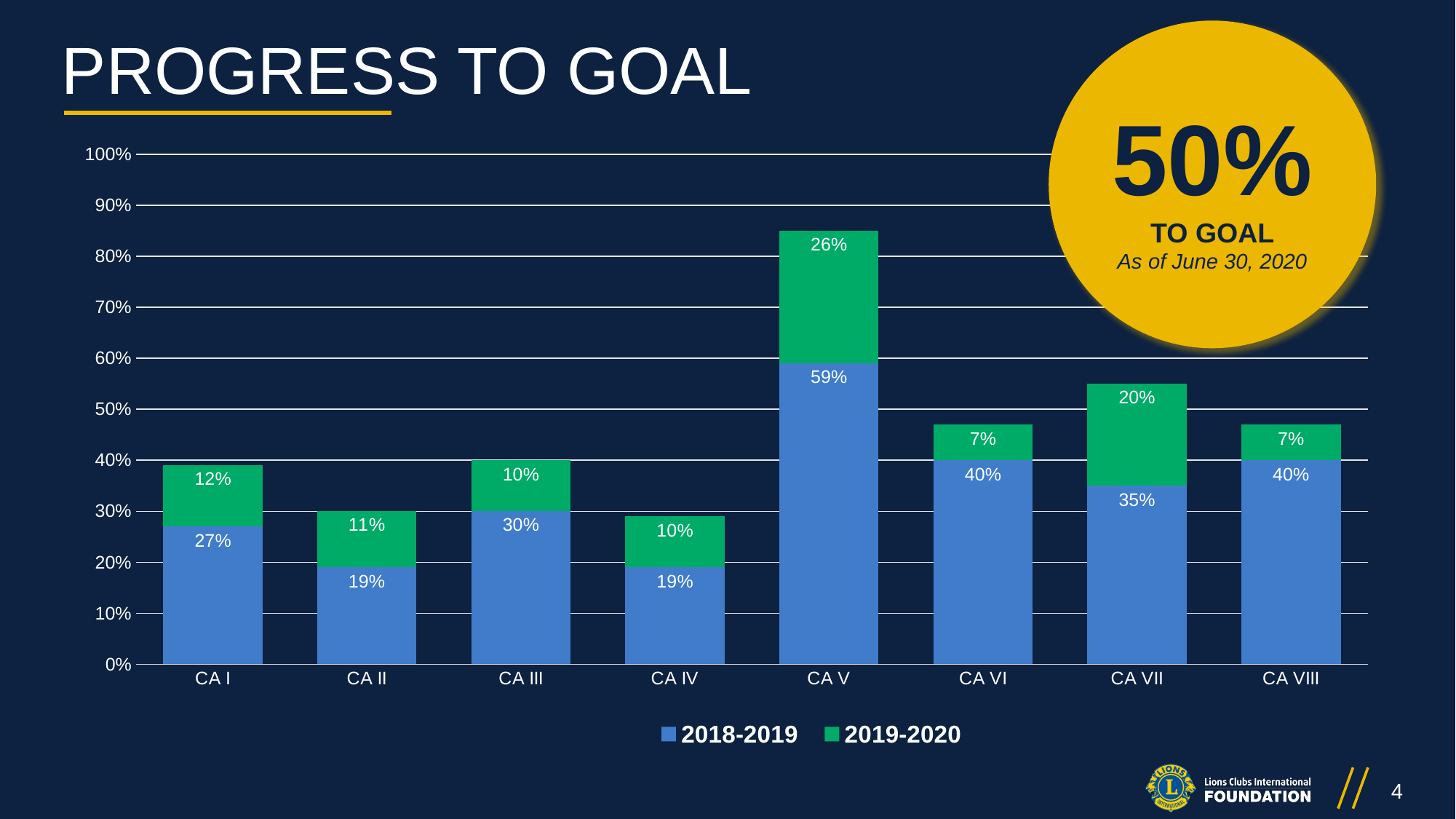
What is the total of the stacked bar for CA V? 85% How many categories are shown on the x axis? 8 Which is larger, the 2018-2019 value for CA III or for CA VII? CA VII How many series does the legend list? 2 What is the total of the stacked bar for CA I? 39% What is the 2018-2019 value for CA II? 19% What kind of chart is shown on the slide? Stacked bar chart Which category has the highest 2018-2019 value? CA V What is the difference between the 2019-2020 values for CA V and CA I? 14% What is the 2019-2020 value for CA VII? 20% Which category has the lowest 2019-2020 value? CA VI and CA VIII What is the 2018-2019 value for CA V? 59%